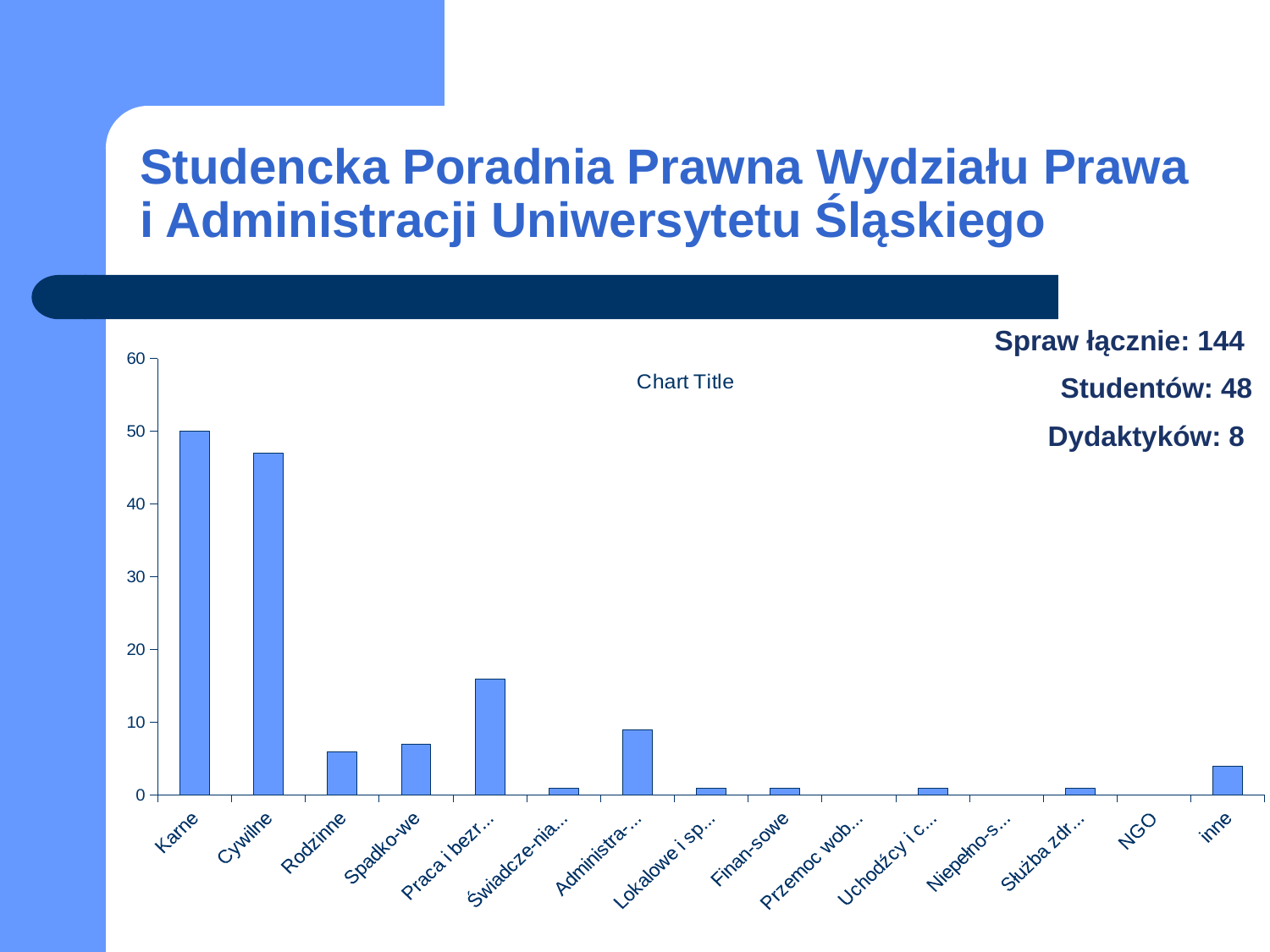
Which category has the highest bar in the chart? Karne Which is larger, the value for Praca i bezr... or the value for Administra-...? Praca i bezr... What is the title shown on the chart? Chart Title Is the value for Cywilne greater or less than 40? greater Is the value for Praca i bezr... greater or less than 10? greater Is the value for Administra-... greater or less than 10? less How many categories are shown on the x axis of the chart? 15 What is the value for Karne in the chart? 50 What kind of chart is shown on the slide? bar chart Which is larger, the value for Karne or the value for Cywilne? Karne